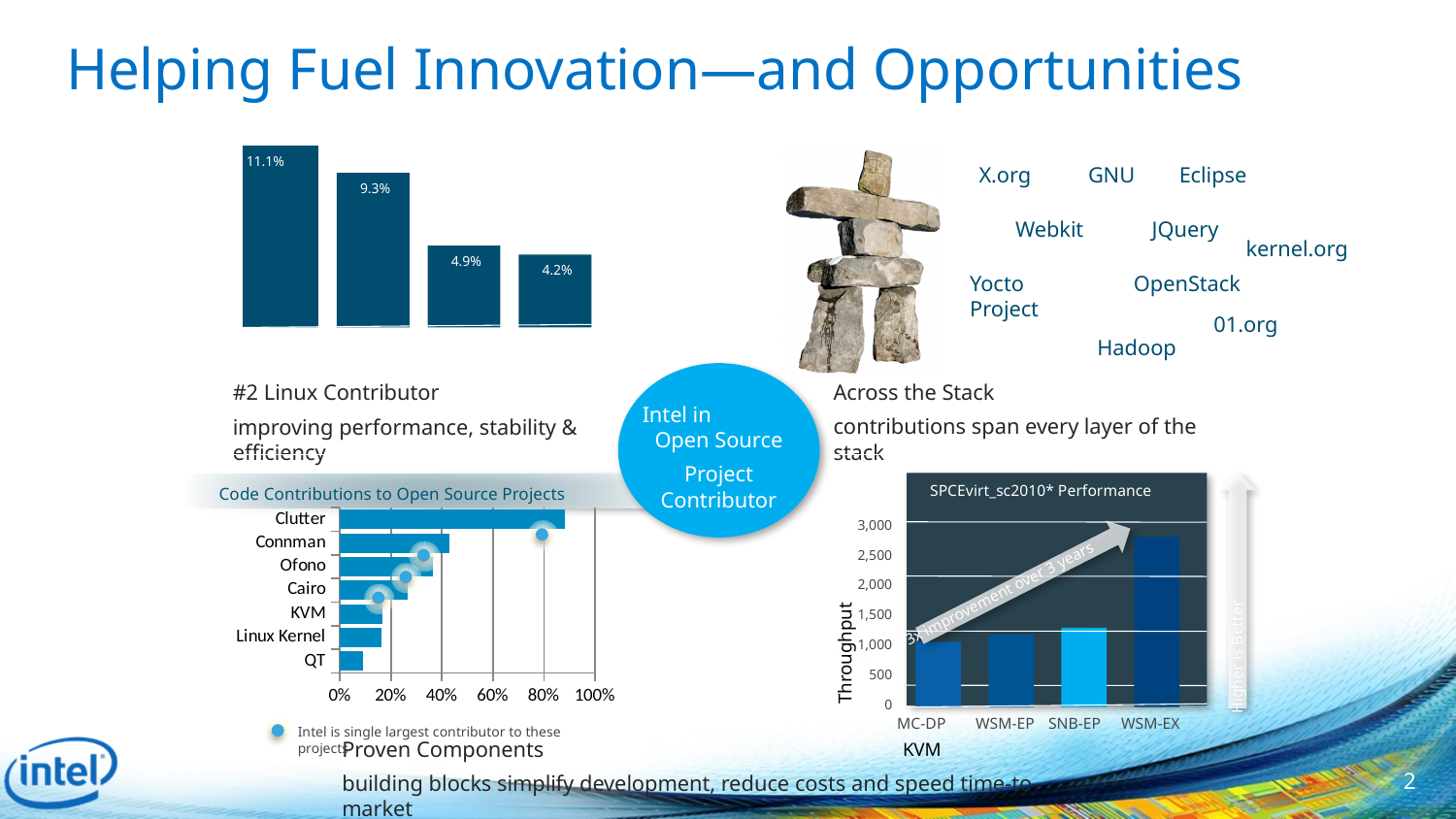
In the 'Code Contributions to Open Source Projects' chart, is the value for Clutter greater or less than 80%? greater In the 'Code Contributions to Open Source Projects' chart, is the value for QT greater or less than 20%? less What kind of chart is 'Code Contributions to Open Source Projects'? bar chart In the bar chart at the top left of the slide, what is the highest value shown? 11.1% In the 'SPCEvirt_sc2010* Performance' chart, is the value for WSM-EX greater or less than 2,500? greater In the 'SPCEvirt_sc2010* Performance' chart, how many categories are shown on the x axis? 4 In the 'SPCEvirt_sc2010* Performance' chart, what is the label on the vertical axis? Throughput In the 'SPCEvirt_sc2010* Performance' chart, which category has the highest throughput? WSM-EX In the 'Code Contributions to Open Source Projects' chart, which project has the highest value? Clutter In the 'Code Contributions to Open Source Projects' chart, which is larger, the value for Connman or the value for Cairo? Connman In the 'Code Contributions to Open Source Projects' chart, how many projects are listed? 7 In the 'Code Contributions to Open Source Projects' chart, which project has the lowest value? QT